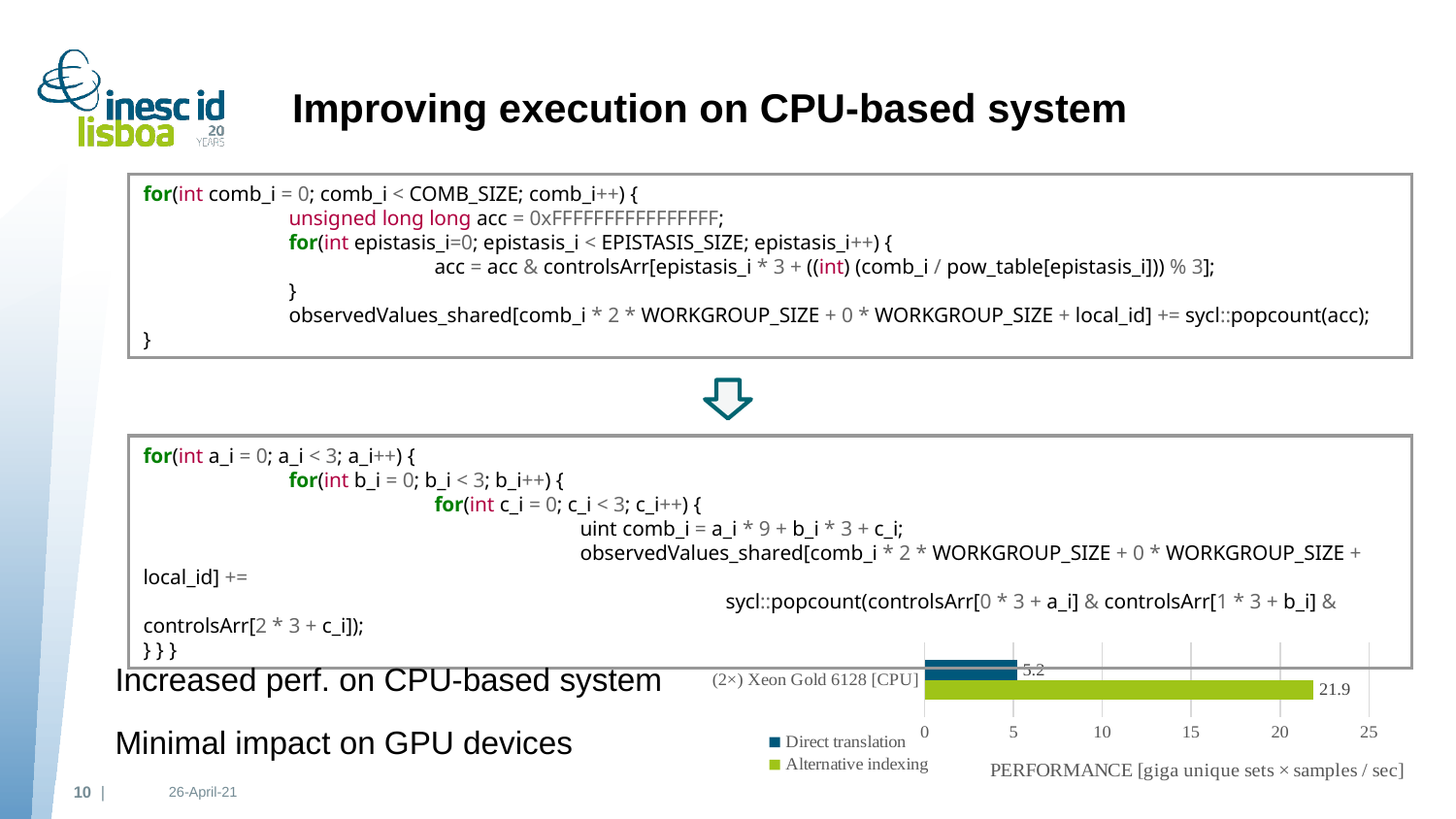
How many categories are shown on the chart's category axis? 1 What is the value for Direct translation on the (2×) Xeon Gold 6128 [CPU]? 5.2 Which series has the higher value for the (2×) Xeon Gold 6128 [CPU]: Direct translation or Alternative indexing? Alternative indexing What is the maximum value shown on the chart's value axis? 25 Is the value for Alternative indexing greater or less than 20? greater Is the value for Direct translation greater or less than 10? less What is the difference between the Alternative indexing and Direct translation values for the (2×) Xeon Gold 6128 [CPU]? 16.7 Which series has the lowest value on the chart? Direct translation How many series does the chart legend list? 2 What is the label of the chart's value axis? PERFORMANCE [giga unique sets × samples / sec] What is the value for Alternative indexing on the (2×) Xeon Gold 6128 [CPU]? 21.9 What kind of chart is shown on the slide? Bar chart